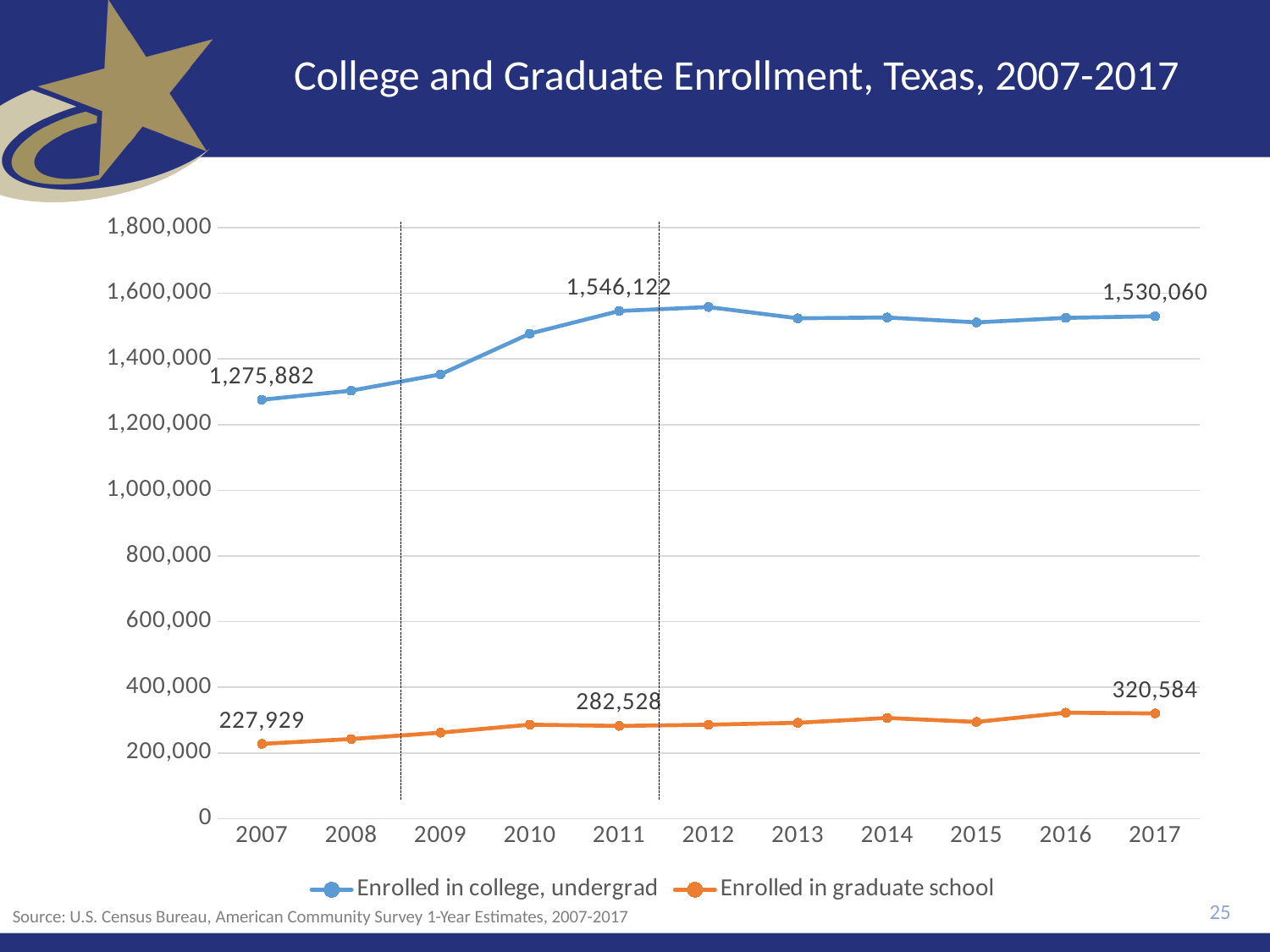
What was the undergraduate college enrollment in 2011? 1,546,122 What is the difference between graduate school enrollment in 2017 and in 2011? 38,056 Did undergraduate enrollment rise or fall between 2007 and 2011? rise How many years are shown on the x axis? 11 Is the undergraduate enrollment value for 2012 greater or less than 1,400,000? greater What was the graduate school enrollment in 2007? 227,929 What type of chart is shown on the slide? line chart By how much did undergraduate enrollment increase from 2007 to 2011? 270,240 How many series does the legend list? 2 What was the graduate school enrollment in 2017? 320,584 Which year has the lowest undergraduate enrollment? 2007 What was the undergraduate college enrollment in Texas in 2007? 1,275,882